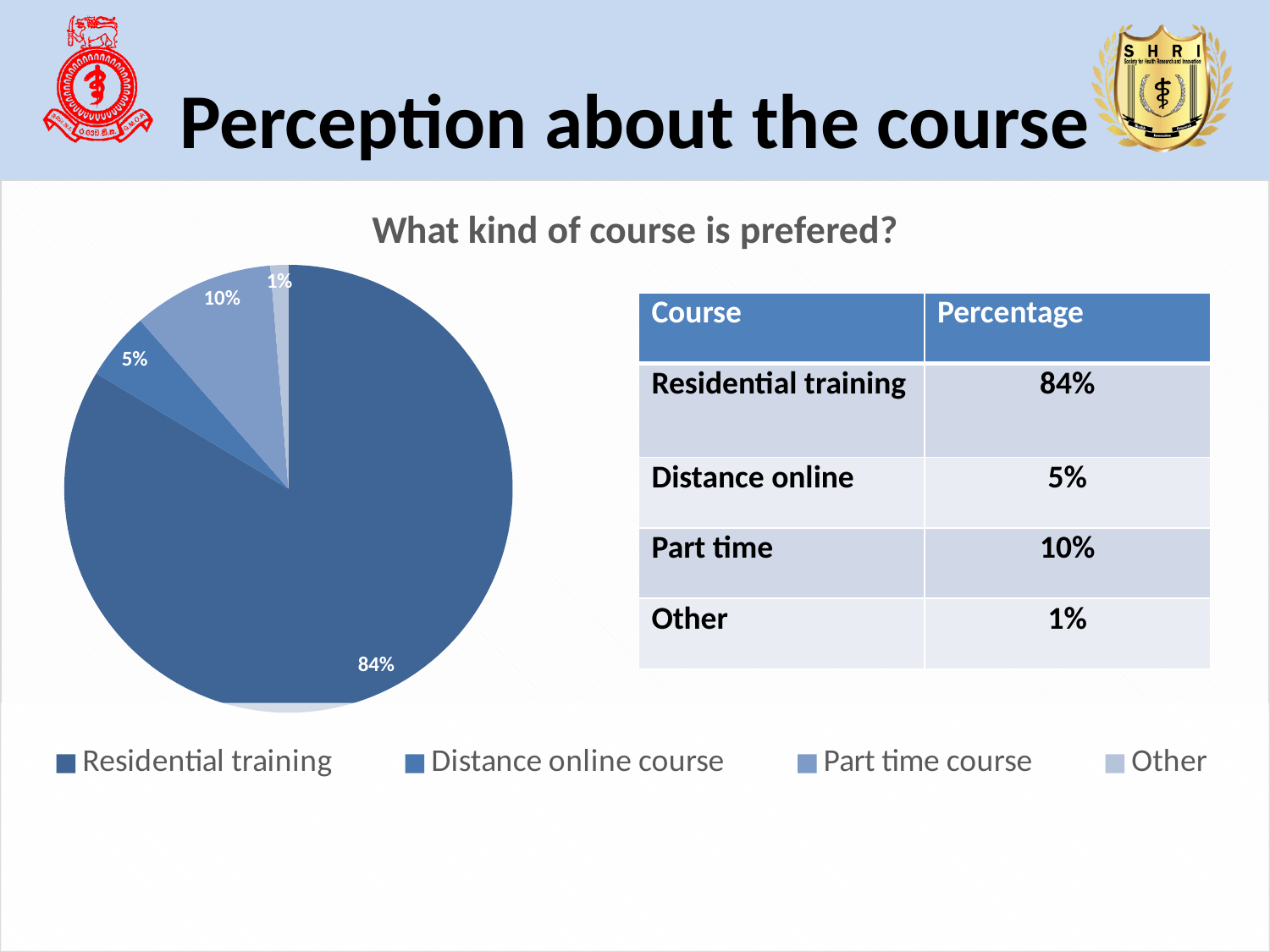
What percentage of the pie is Part time course? 10% What percentage of the pie is Other? 1% Which category has the smallest slice of the pie? Other What is the title of the chart? What kind of course is prefered? What percentage of the pie is Residential training? 84% What percentage of the pie is Distance online course? 5% What type of chart is shown on the slide? Pie chart Which is larger, the Part time course slice or the Distance online course slice? Part time course Which category has the largest slice of the pie? Residential training How many categories does the legend list? 4 What is the difference in percentage points between Residential training and Part time course? 74 What is the difference in percentage points between Part time course and Distance online course? 5